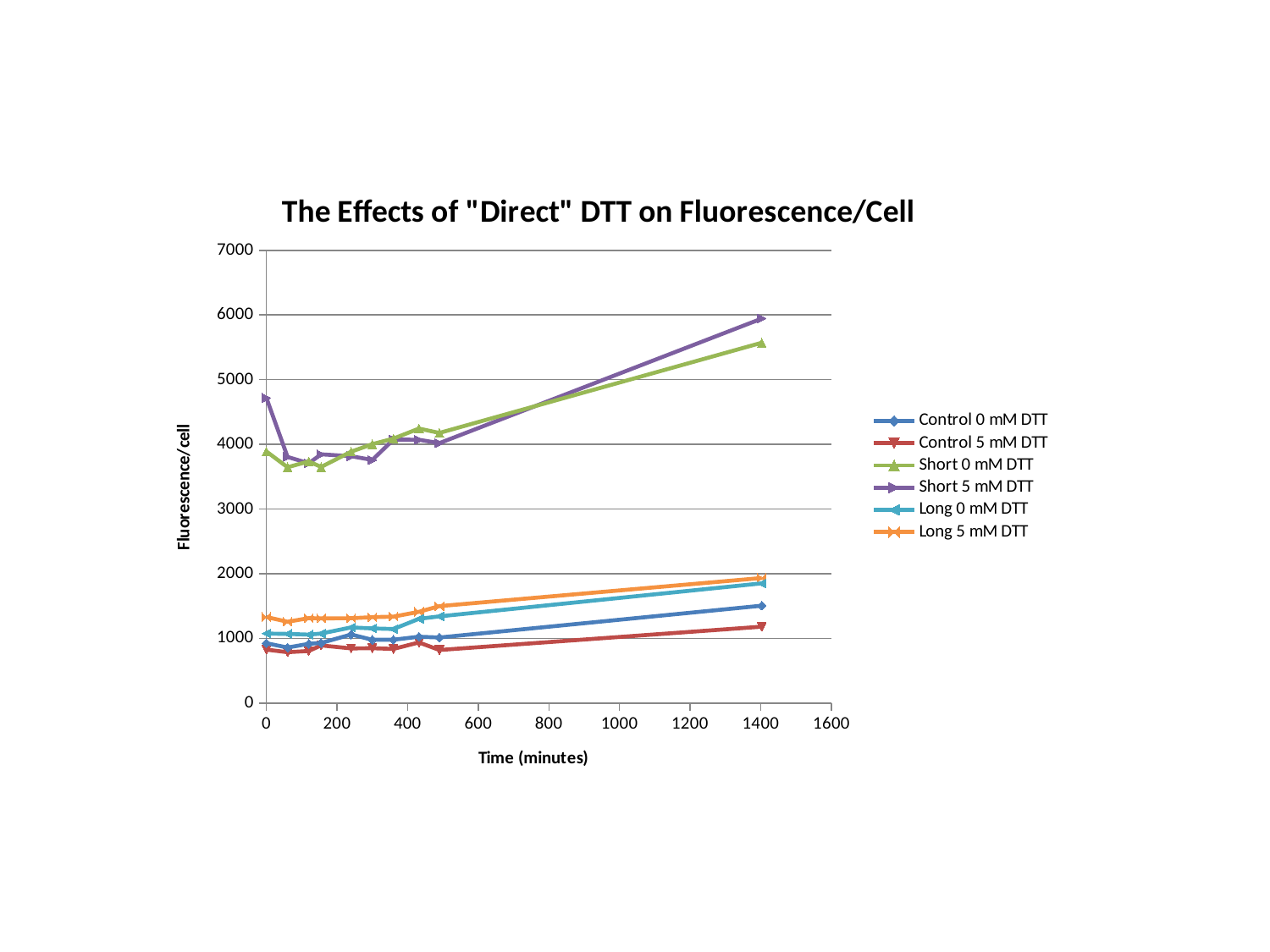
At 1400 minutes, which is larger: Long 5 mM DTT or Control 0 mM DTT? Long 5 mM DTT Is the value for Control 0 mM DTT at 1400 minutes greater or less than 1000? greater What is the title of the chart? The Effects of "Direct" DTT on Fluorescence/Cell Is the value for Short 5 mM DTT at 1400 minutes greater or less than 5000? greater Is the value for Short 5 mM DTT at 0 minutes greater or less than 4000? greater How many series does the legend list? 6 What is the label of the x axis? Time (minutes) Does the Control 0 mM DTT series rise or fall from 0 to 1400 minutes? rise Which series has the highest value at 1400 minutes? Short 5 mM DTT Which series has the lowest value at 1400 minutes? Control 5 mM DTT What kind of chart is shown on the slide? line chart